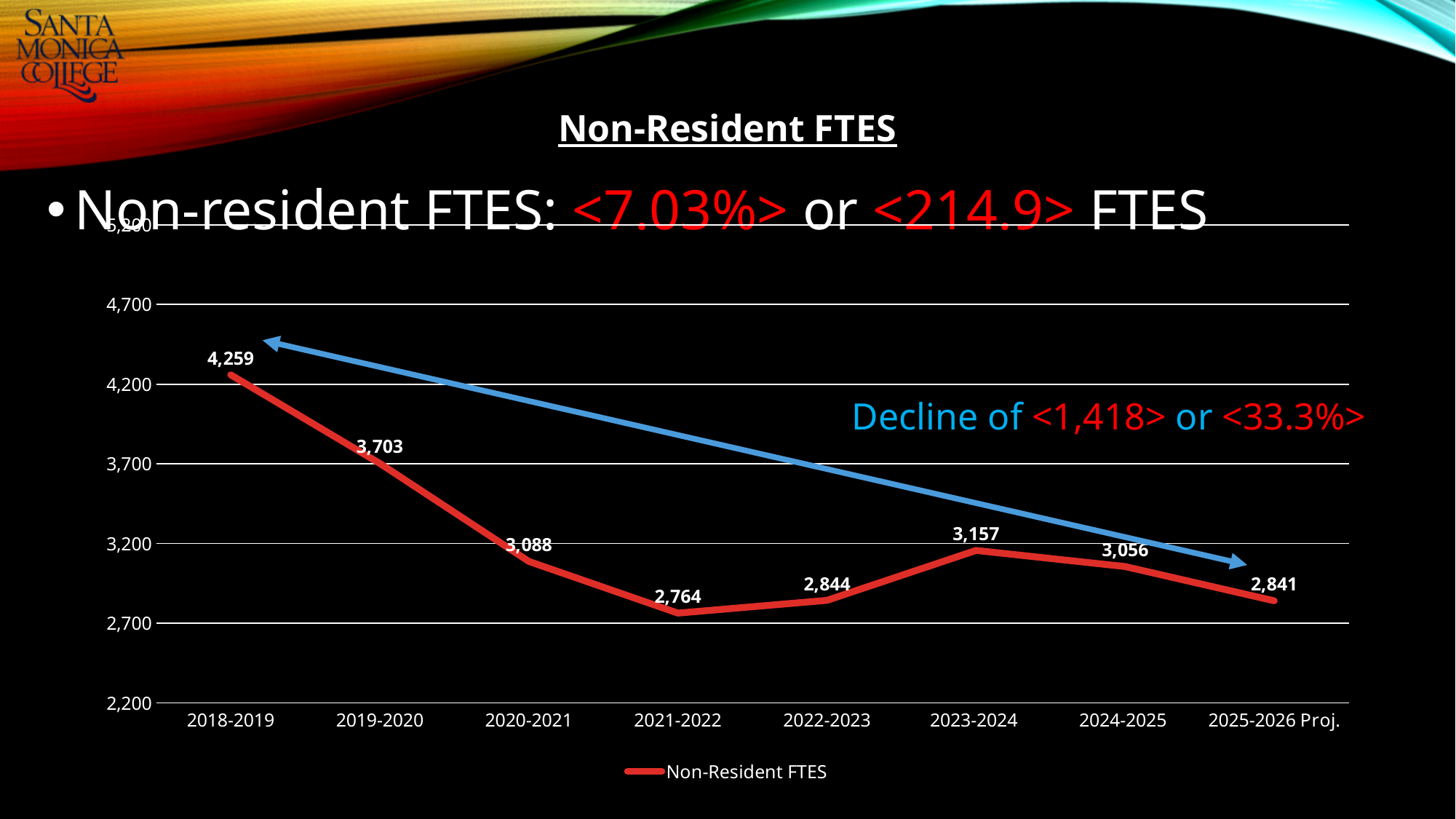
Which year has the lowest Non-Resident FTES value? 2021-2022 Which is larger, the Non-Resident FTES value for 2022-2023 or for 2023-2024? 2023-2024 What is the Non-Resident FTES value for 2021-2022? 2,764 What kind of chart is shown on the slide? line chart What is the name of the series shown in the chart legend? Non-Resident FTES What is the projected Non-Resident FTES value for 2025-2026? 2,841 What is the difference between the Non-Resident FTES values for 2023-2024 and 2024-2025? 101 Is the Non-Resident FTES value for 2020-2021 greater or less than 3,200? less How many years are plotted on the x axis of the chart? 8 What is the difference between the Non-Resident FTES values for 2018-2019 and 2019-2020? 556 Which year has the highest Non-Resident FTES value? 2018-2019 What is the Non-Resident FTES value for 2018-2019? 4,259